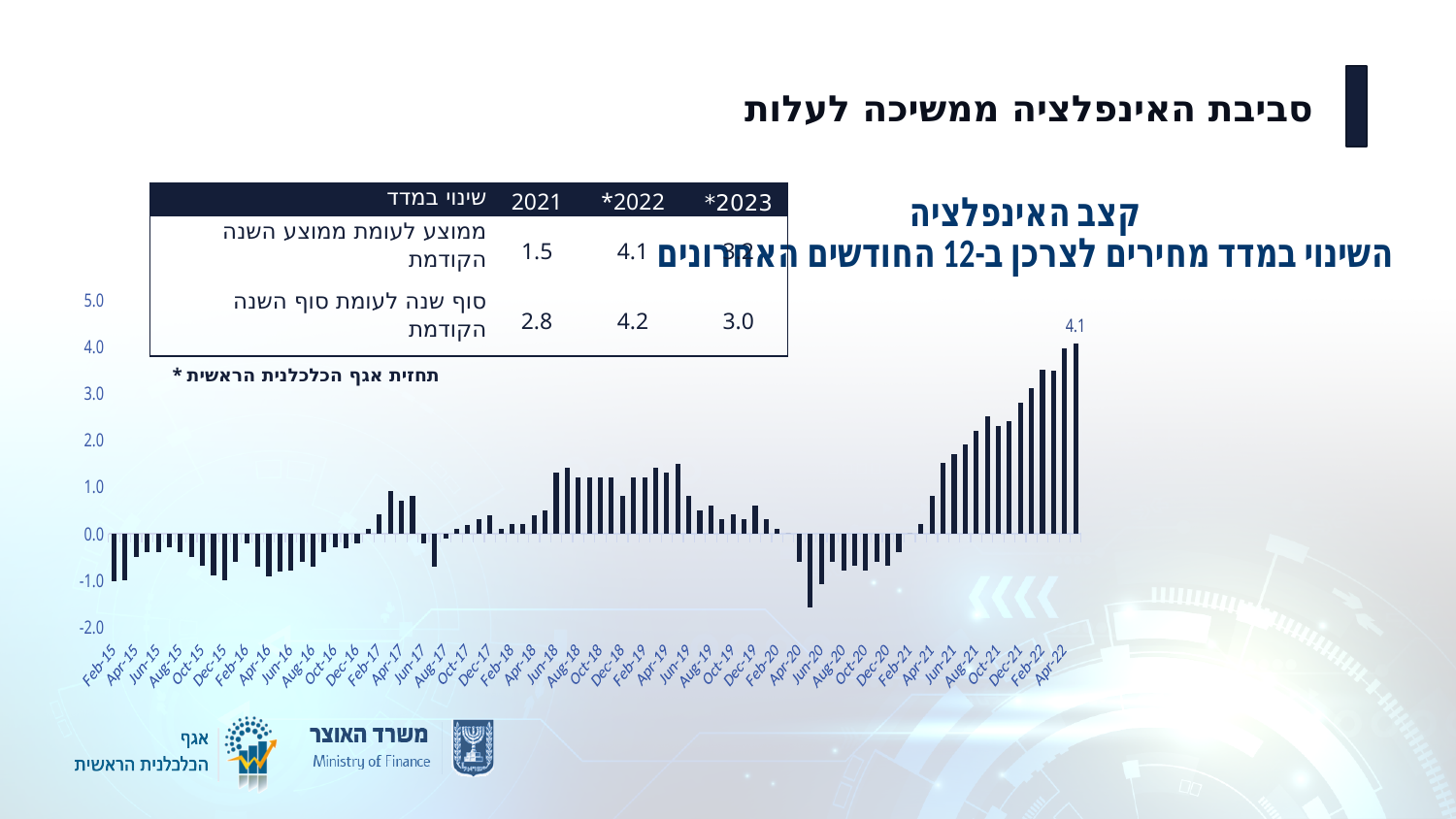
What is the highest value shown on the chart? 4.1 Is the value for Feb-15 greater or less than 0.0? less What is the first month label on the horizontal axis? Feb-15 What is the highest tick value shown on the vertical axis? 5.0 What value is printed on the last (most recent) bar of the chart? 4.1 Is the lowest bar on the chart greater or less than -1.0? less What kind of chart is shown on the slide? bar chart Do the values rise or fall from Feb-21 to the end of the chart? rise Which is larger, the value for Feb-15 or the value of the last bar on the chart? the last bar In which year does the lowest bar on the chart occur? 2020 Is the value for Jun-21 greater or less than 1.0? greater